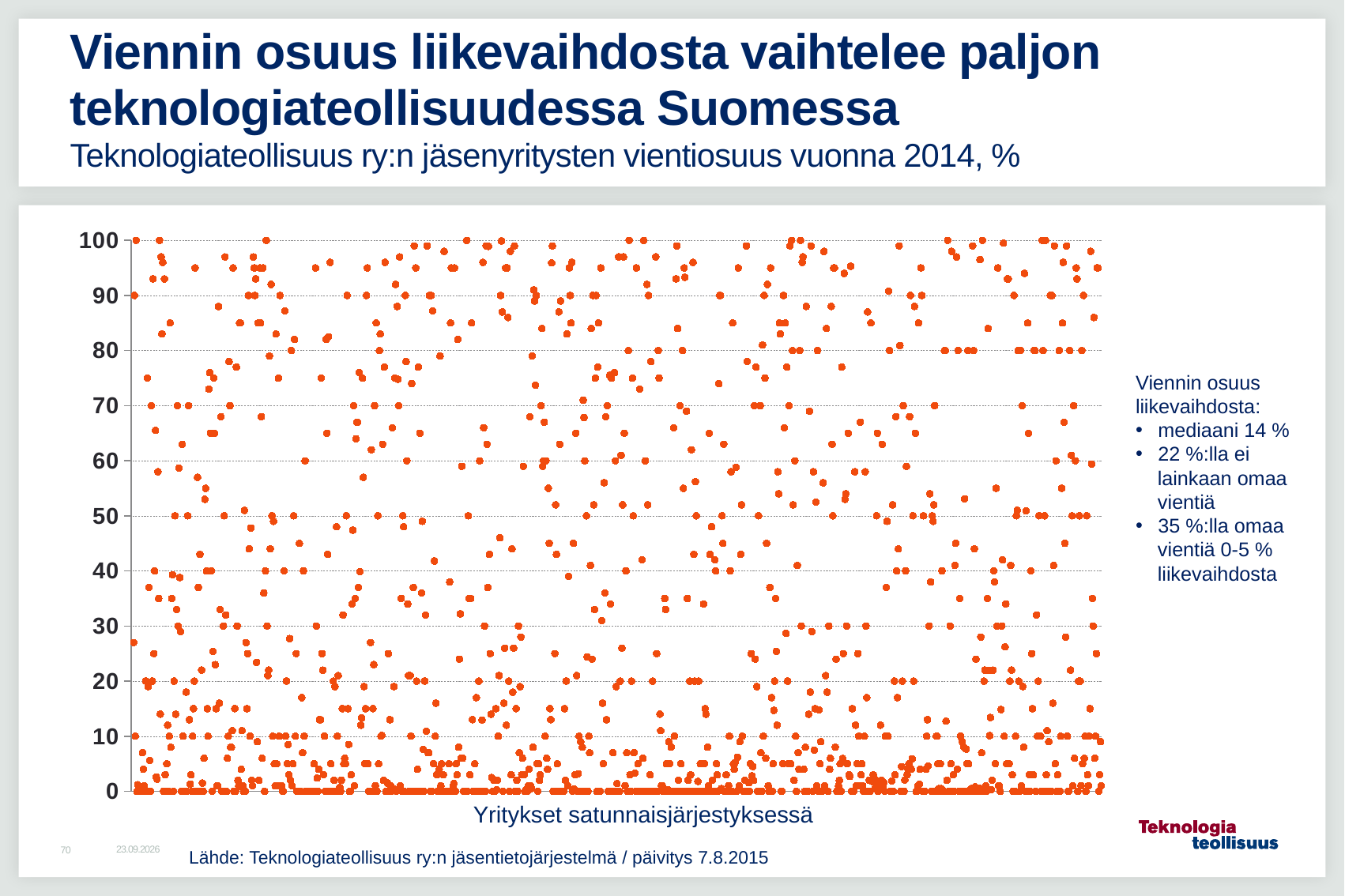
What is the lowest value shown on the vertical axis of the chart? 0 Which year does the chart's data refer to, according to the subtitle? 2014 What kind of chart is shown on the slide? scatter chart What colour are the data points in the chart? orange According to the text beside the chart, what percentage of companies have exports of 0-5 % of turnover? 35 % What is the label of the horizontal axis of the chart? Yritykset satunnaisjärjestyksessä What is the highest value shown on the vertical axis of the chart? 100 According to the text beside the chart, what percentage of companies have no exports at all? 22 % According to the text beside the chart, what is the median export share of turnover? 14 %